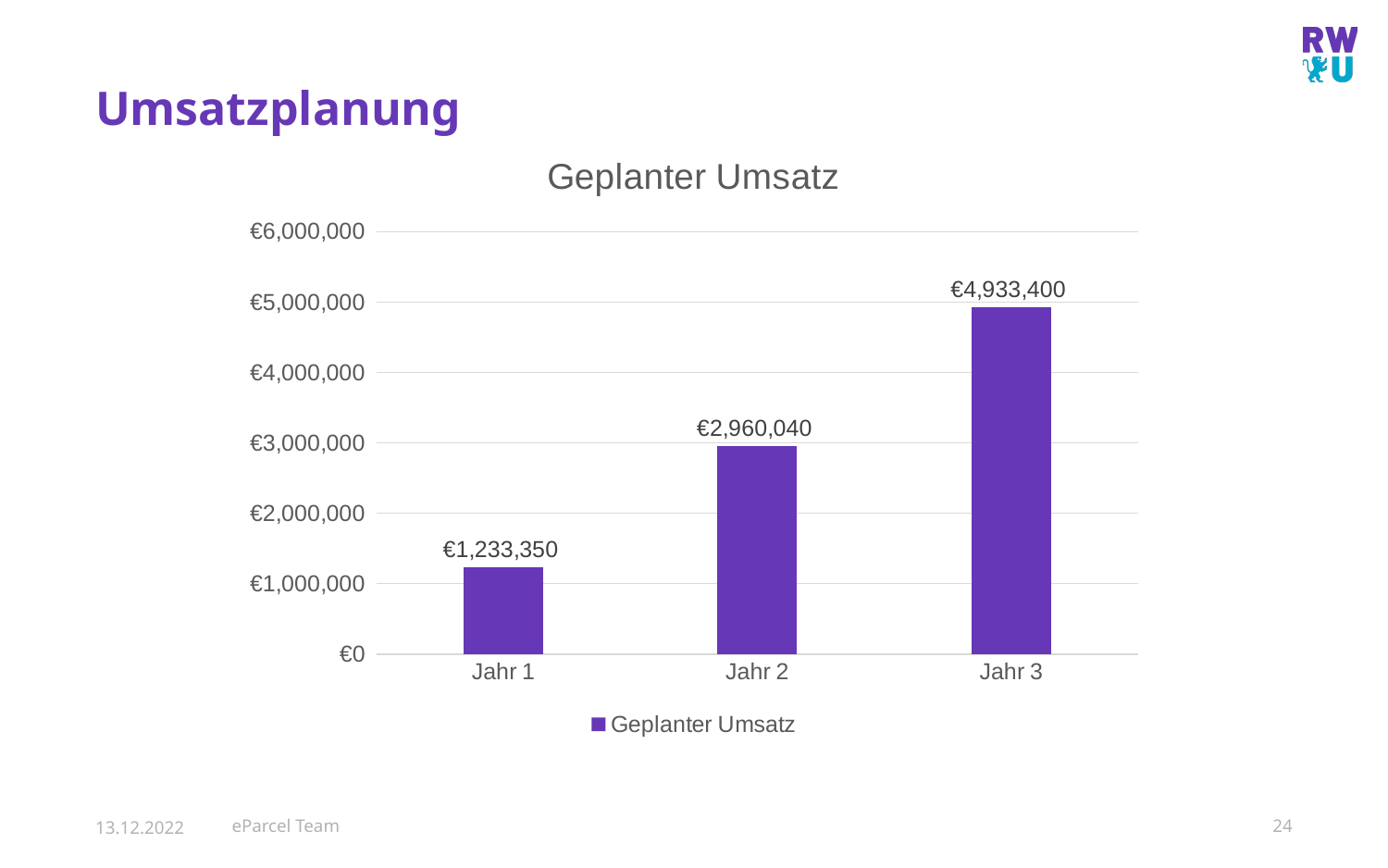
Do the planned revenue values rise or fall from Jahr 1 to Jahr 3? Rise Which is larger, the planned revenue for Jahr 1 or Jahr 2? Jahr 2 Which year has the highest planned revenue? Jahr 3 What kind of chart is shown on the slide? Bar chart What is the difference between the planned revenue for Jahr 2 and Jahr 1? €1,726,690 Is the planned revenue for Jahr 3 greater or less than €4,000,000? greater What is the difference between the planned revenue for Jahr 3 and Jahr 2? €1,973,360 How many years are shown on the x axis of the chart? 3 What is the planned revenue (Geplanter Umsatz) for Jahr 1? €1,233,350 What is the planned revenue for Jahr 3? €4,933,400 What is the planned revenue for Jahr 2? €2,960,040 Which year has the lowest planned revenue? Jahr 1